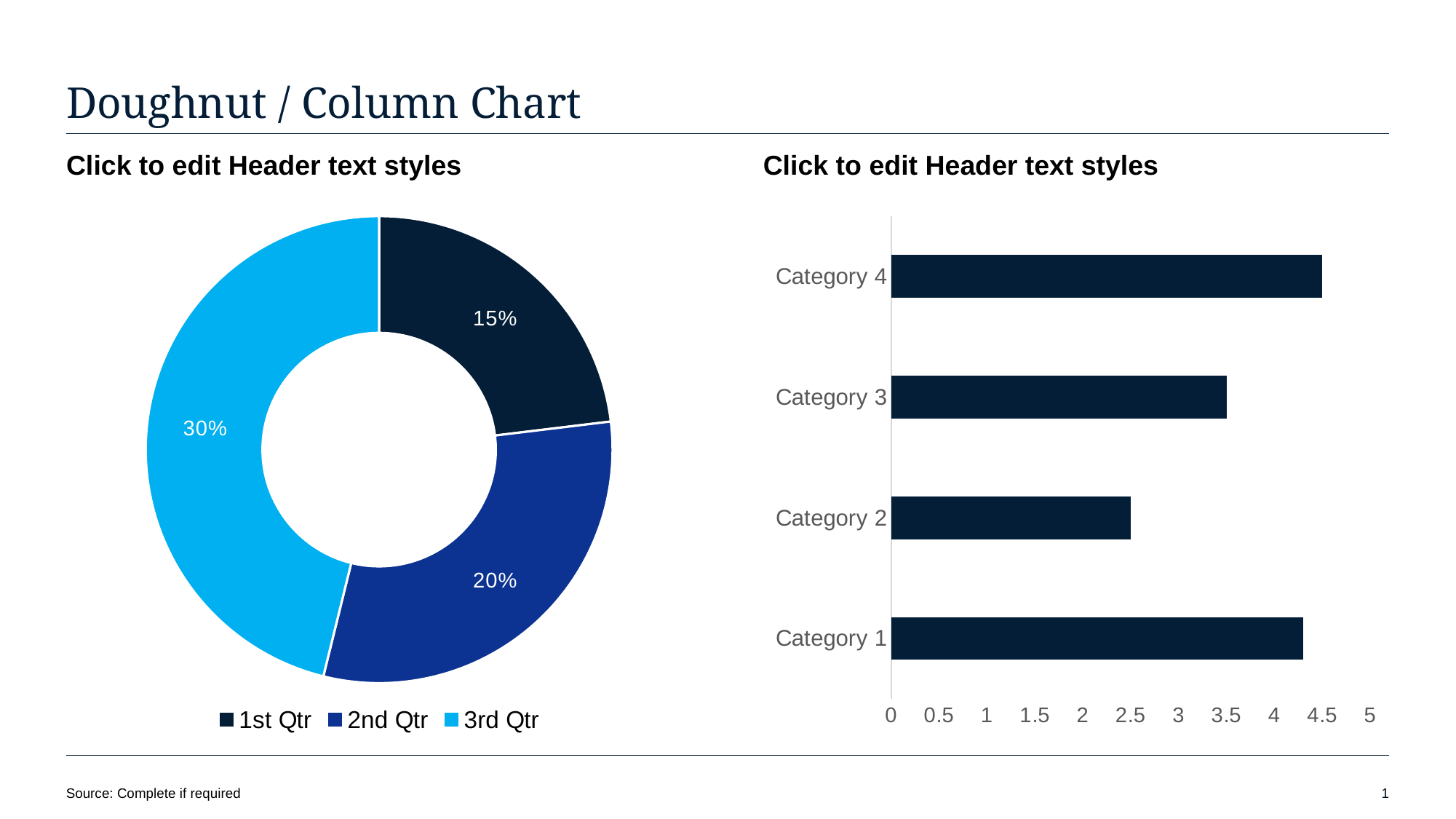
In the bar chart on the right, which is larger, Category 3 or Category 2? Category 3 In the bar chart on the right, what is the value for Category 3? 3.5 In the doughnut chart on the left, which quarter has the largest segment? 3rd Qtr In the doughnut chart on the left, what value is shown for 1st Qtr? 15% How many entries does the legend of the doughnut chart on the left list? 3 In the doughnut chart on the left, which quarter has the smallest segment? 1st Qtr What kind of chart is shown on the right side of the slide? Bar chart In the bar chart on the right, is the value for Category 1 greater or less than 4? greater In the doughnut chart on the left, what value is shown for 3rd Qtr? 30% How many categories are plotted in the bar chart on the right? 4 In the bar chart on the right, which category has the lowest value? Category 2 In the doughnut chart on the left, what is the difference between the 3rd Qtr and 2nd Qtr values? 10%